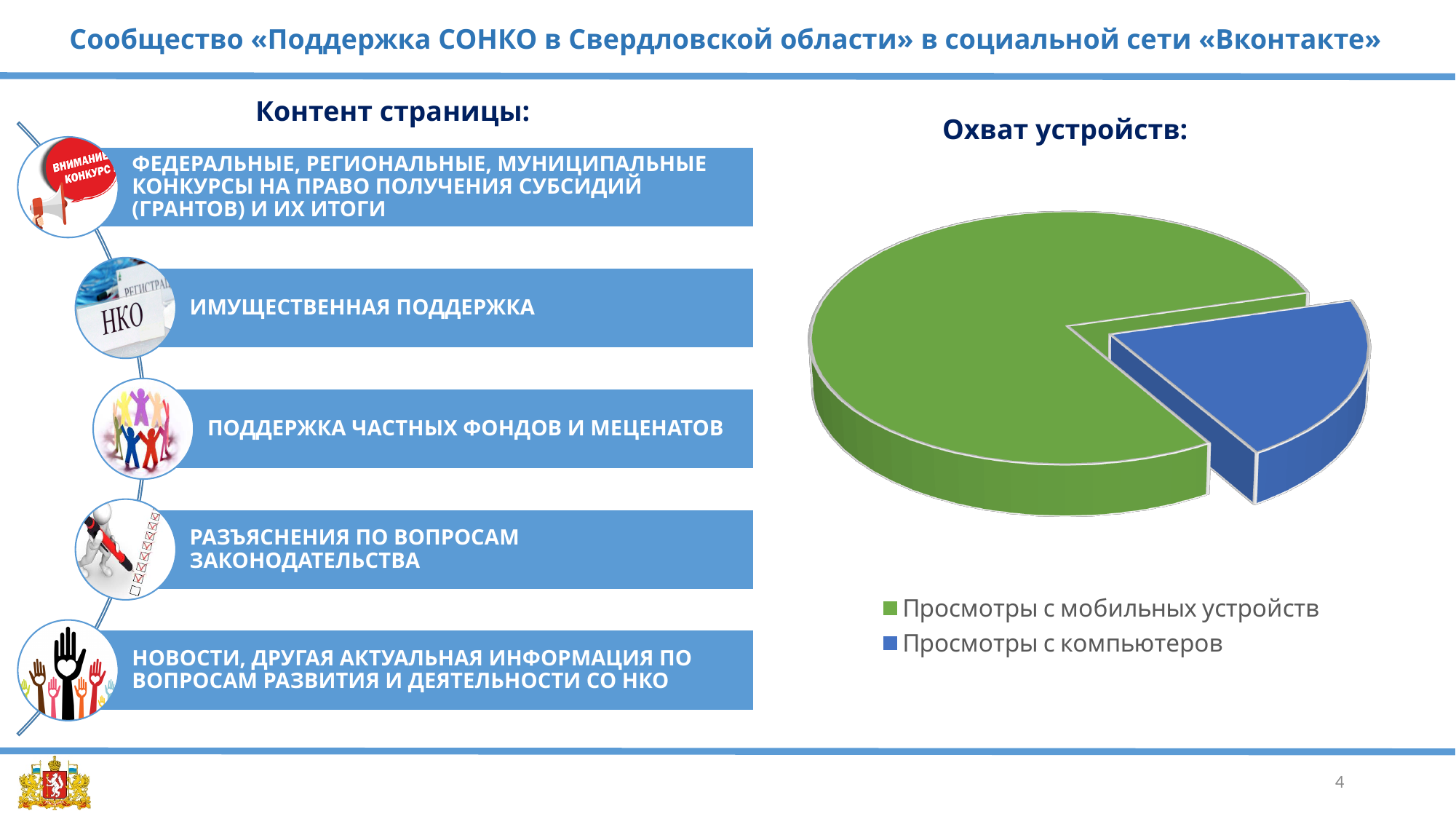
What kind of chart is shown under "Охват устройств:"? pie chart Which category has the largest slice in the pie chart? Просмотры с мобильных устройств How many entries does the legend of the pie chart list? 2 Which slice is larger: "Просмотры с мобильных устройств" or "Просмотры с компьютеров"? Просмотры с мобильных устройств What colour is the slice for "Просмотры с компьютеров" in the pie chart? blue What is the title of the pie chart on the right side of the slide? Охват устройств: How many slices does the pie chart "Охват устройств:" have? 2 Which category has the smallest slice in the pie chart? Просмотры с компьютеров